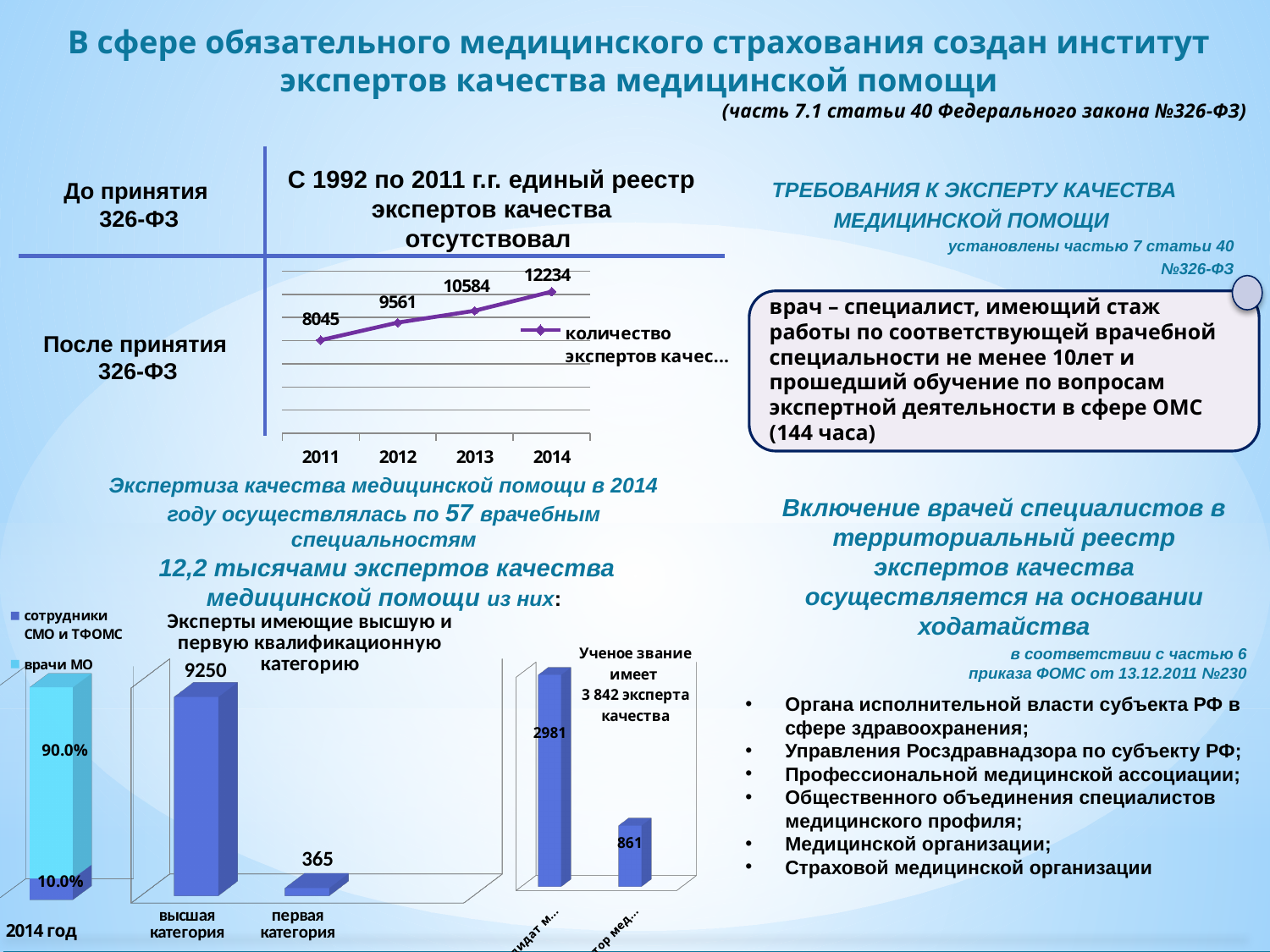
In the bar chart titled 'Эксперты имеющие высшую и первую квалификационную категорию', what is the value for 'высшая категория'? 9250 In the line chart at the top of the slide, what is the number of quality experts in 2014? 12234 In the bar chart titled 'Эксперты имеющие высшую и первую квалификационную категорию', which category has the higher value? высшая категория In the line chart at the top of the slide, what is the value for 2013? 10584 In the line chart at the top of the slide, what is the difference between the 2014 and 2011 values? 4189 How many series does the legend of the stacked bar chart at the bottom left list? 2 How many years are plotted in the line chart at the top of the slide? 4 In the line chart at the top of the slide, what is the number of quality experts in 2011? 8045 What type of chart is the chart at the top of the slide showing values for 2011 to 2014? line chart In the line chart at the top of the slide, do the values rise or fall from 2011 to 2014? rise In the bar chart titled 'Эксперты имеющие высшую и первую квалификационную категорию', what is the value for 'первая категория'? 365 In the stacked bar chart at the bottom left for '2014 год', what share is shown for 'врачи МО'? 90.0%